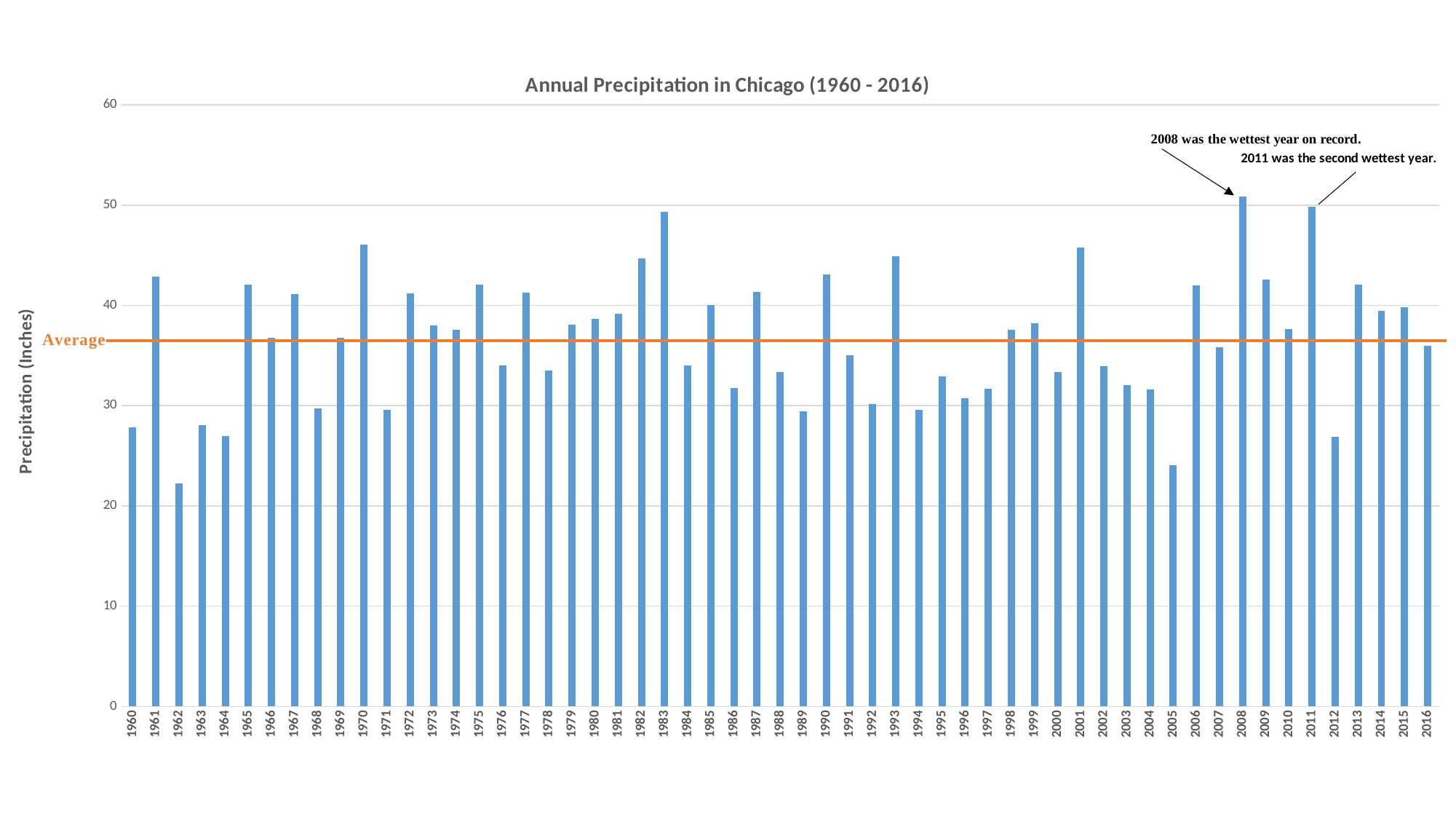
Which year has the highest annual precipitation in the chart? 2008 Which year had more precipitation, 1983 or 1970? 1983 Is the precipitation value for 1962 greater or less than 30? less Is the precipitation value for 1983 greater or less than 40? greater Which year has the lowest annual precipitation in the chart? 1962 What does the orange horizontal line on the chart represent? Average What type of chart is shown on the slide? Bar chart How many years (bars) are plotted in the chart? 57 Which year had more precipitation, 2008 or 2011? 2008 Is the precipitation value for 2012 greater or less than 30? less What is the title of the chart? Annual Precipitation in Chicago (1960 - 2016)